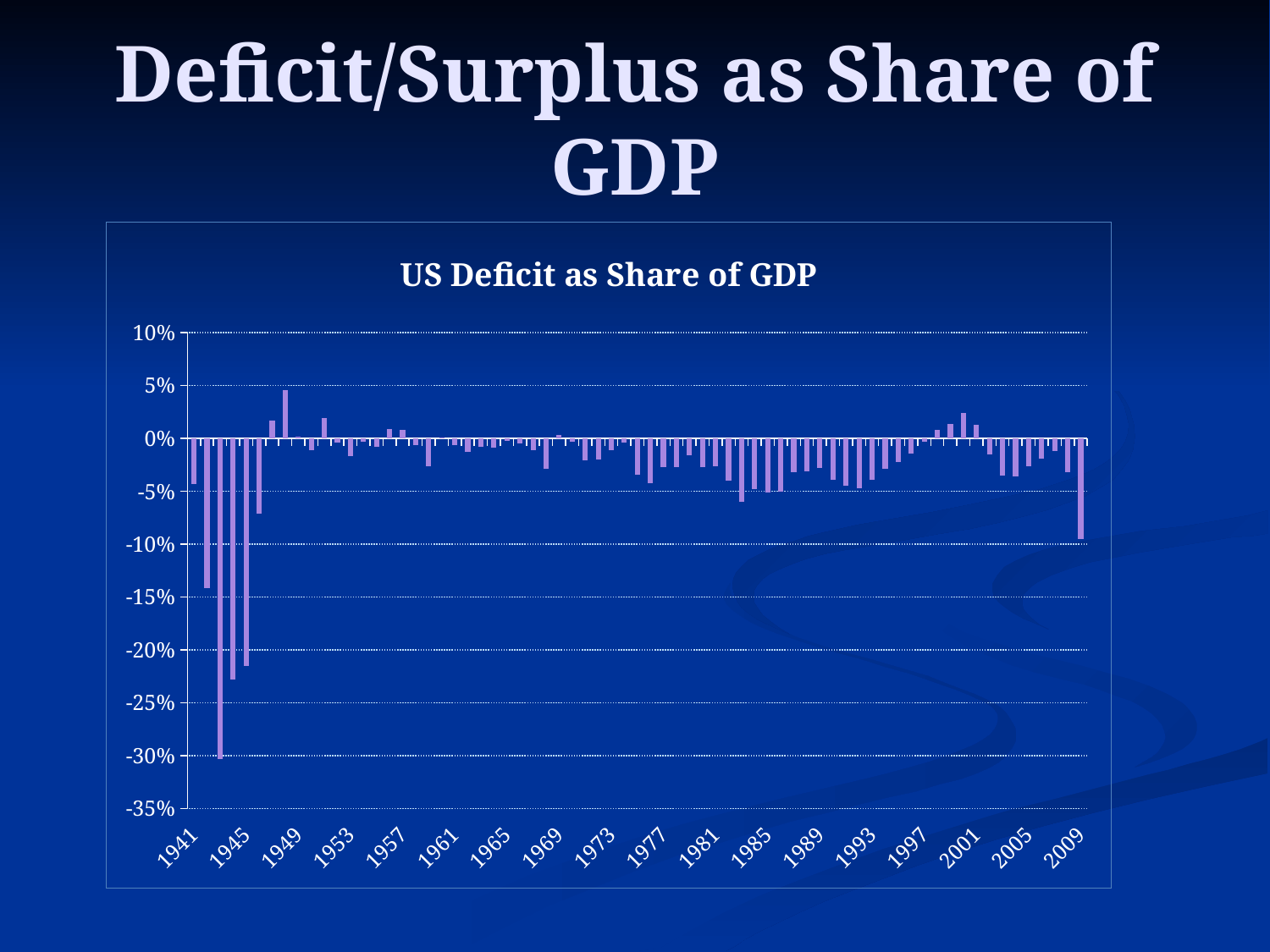
Is the value for 1993 greater or less than 0%? less What is the title of the chart? US Deficit as Share of GDP What are the lowest and highest values shown on the y axis? -35% and 10% Do the values generally rise or fall from 2001 to 2009? fall Is the value for 1941 greater or less than 0%? less Which year has the lower value, 2009 or 1985? 2009 Which year has the lower value, 1945 or 2009? 1945 How many year labels are shown on the x axis? 18 Is the value for 2001 greater or less than 0%? greater What kind of chart is shown on the slide? bar chart